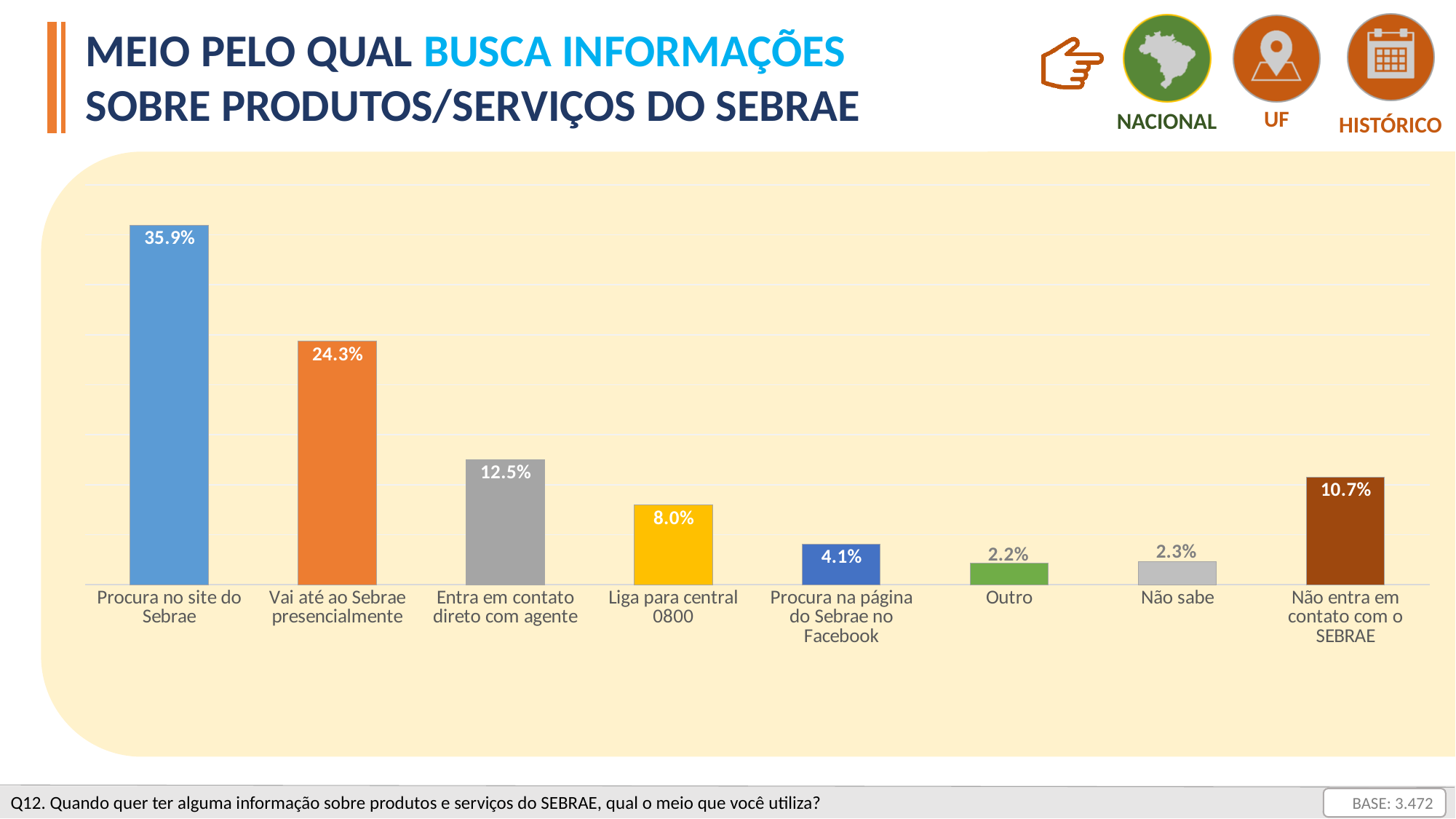
Which category has the highest value? Procura no site do Sebrae What is the value for 'Liga para central 0800'? 8.0% What kind of chart is shown on the slide? Bar chart What is the value for 'Não entra em contato com o SEBRAE'? 10.7% What is the base (number of respondents) shown on the slide? 3.472 What is the value for 'Vai até ao Sebrae presencialmente'? 24.3% Which is larger: 'Não entra em contato com o SEBRAE' or 'Liga para central 0800'? Não entra em contato com o SEBRAE How many categories are shown in the chart? 8 What is the value for 'Procura no site do Sebrae'? 35.9% What is the difference between 'Entra em contato direto com agente' and 'Liga para central 0800'? 4.5% What is the difference between 'Procura no site do Sebrae' and 'Vai até ao Sebrae presencialmente'? 11.6% Which category has the lowest value? Outro